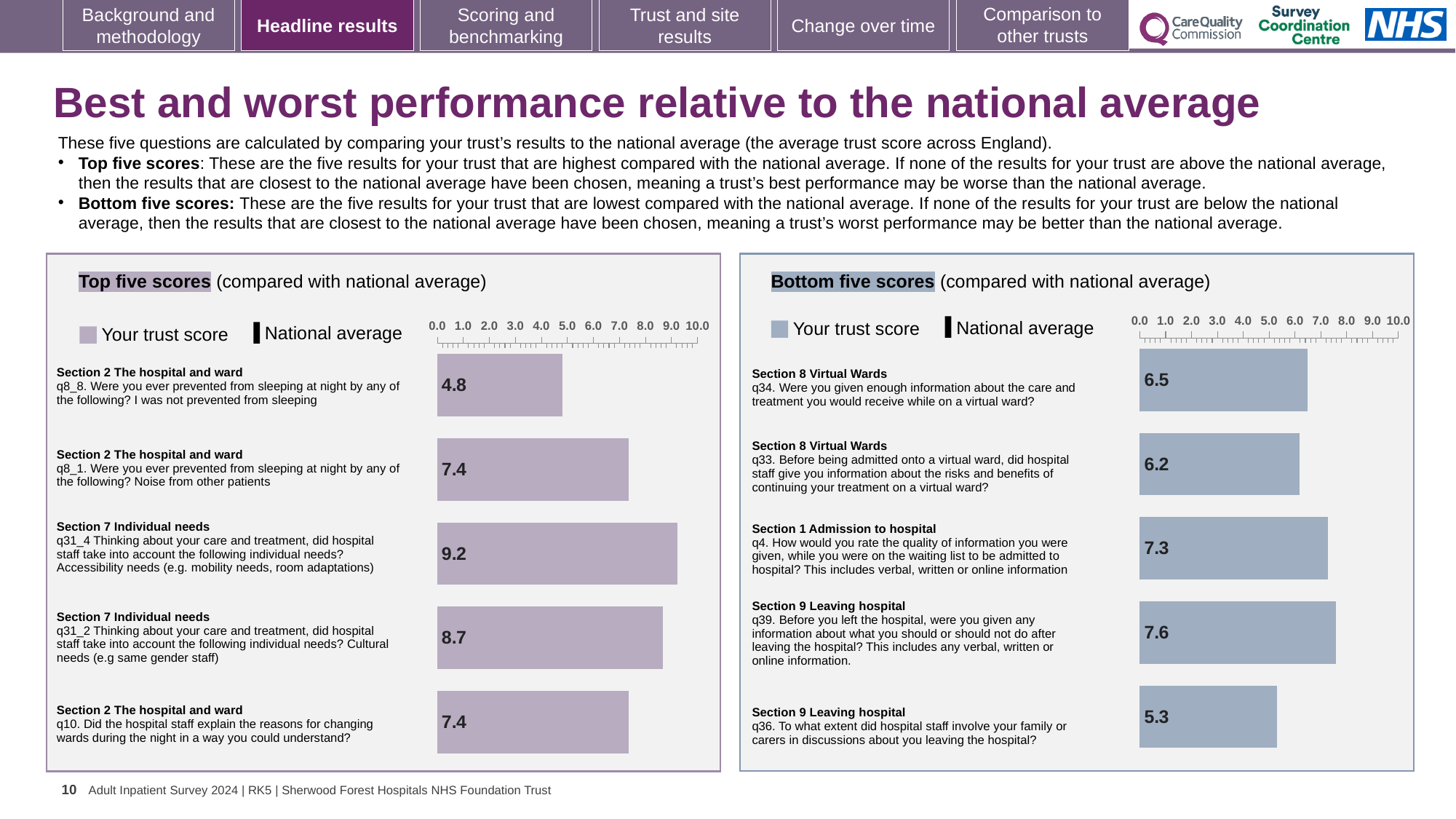
In the Top five scores chart, which question has the highest trust score? q31_4 (Accessibility needs) How many entries does the legend of the Top five scores chart list? 2 In the Bottom five scores chart, which has the larger trust score, q34 or q4? q4 In the Top five scores chart, what is the trust score for q31_4 (Accessibility needs)? 9.2 In the Bottom five scores chart, which question has the lowest trust score? q36 In the Bottom five scores chart, what is the trust score for q39 (information about what to do after leaving hospital)? 7.6 In the Bottom five scores chart, what is the difference between the trust scores for q39 and q33? 1.4 How many questions are shown in the Bottom five scores chart? 5 In the Top five scores chart, what is the difference between the trust scores for q31_4 and q8_8? 4.4 What kind of chart is used in the Top five scores panel? Bar chart In the Bottom five scores chart, what is the trust score for q36 (involving family or carers in discussions about leaving hospital)? 5.3 In the Top five scores chart, what is the trust score for q8_8 (I was not prevented from sleeping)? 4.8